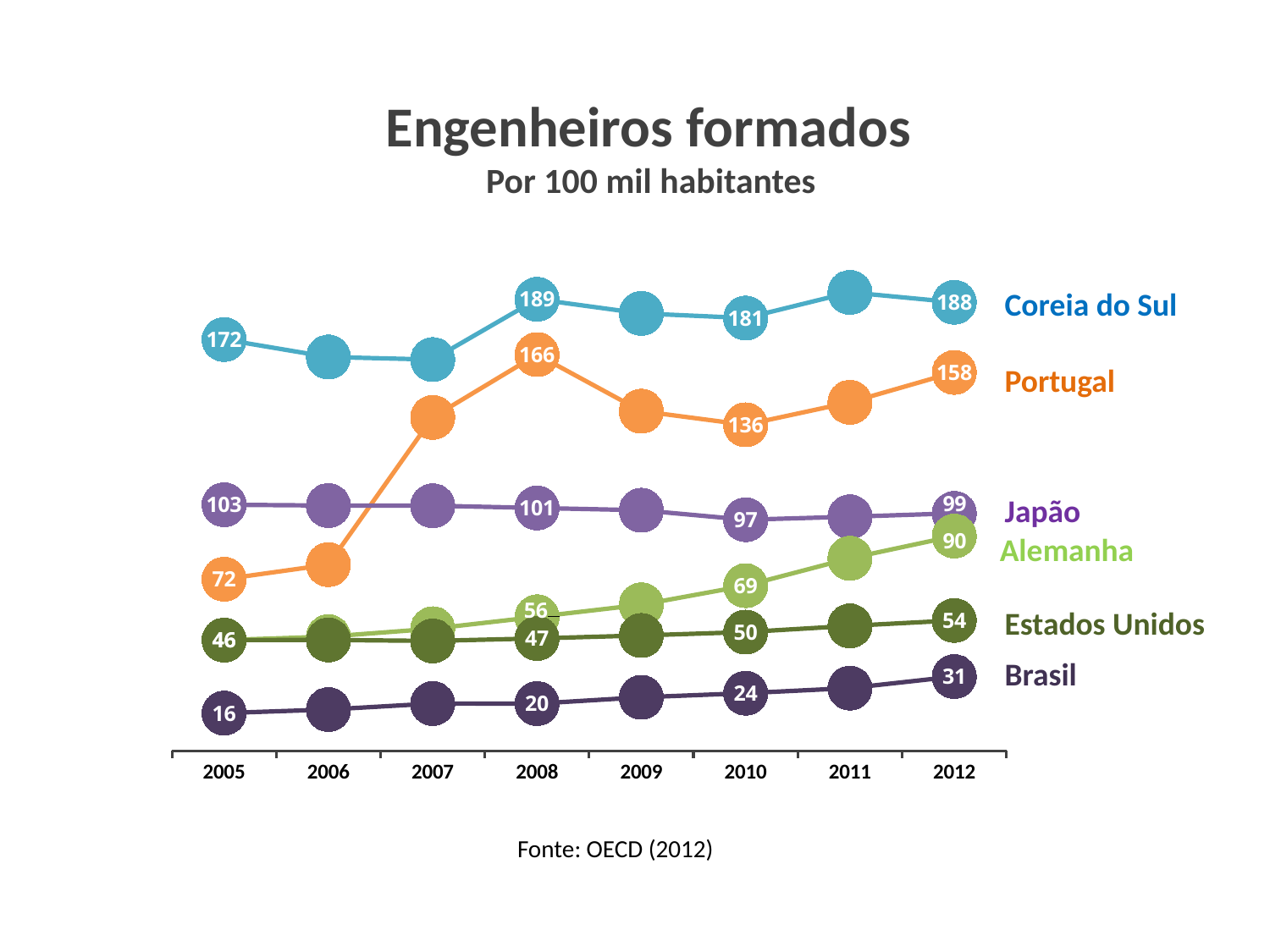
What is the value for Brasil in 2012? 31 Which country has the lowest value in 2005? Brasil Does the value for Brasil rise or fall from 2005 to 2012? Rise How many years are shown on the x axis? 8 Which country has the highest value in 2012? Coreia do Sul What is the difference between Portugal's value in 2008 and its value in 2010? 30 What kind of chart is shown on the slide? Line chart How many series (countries) are plotted on the chart? 6 Which is larger in 2012, the value for Japão or the value for Alemanha? Japão What is the value for Coreia do Sul in 2008? 189 What is the value for Alemanha in 2010? 69 What is the value for Portugal in 2005? 72